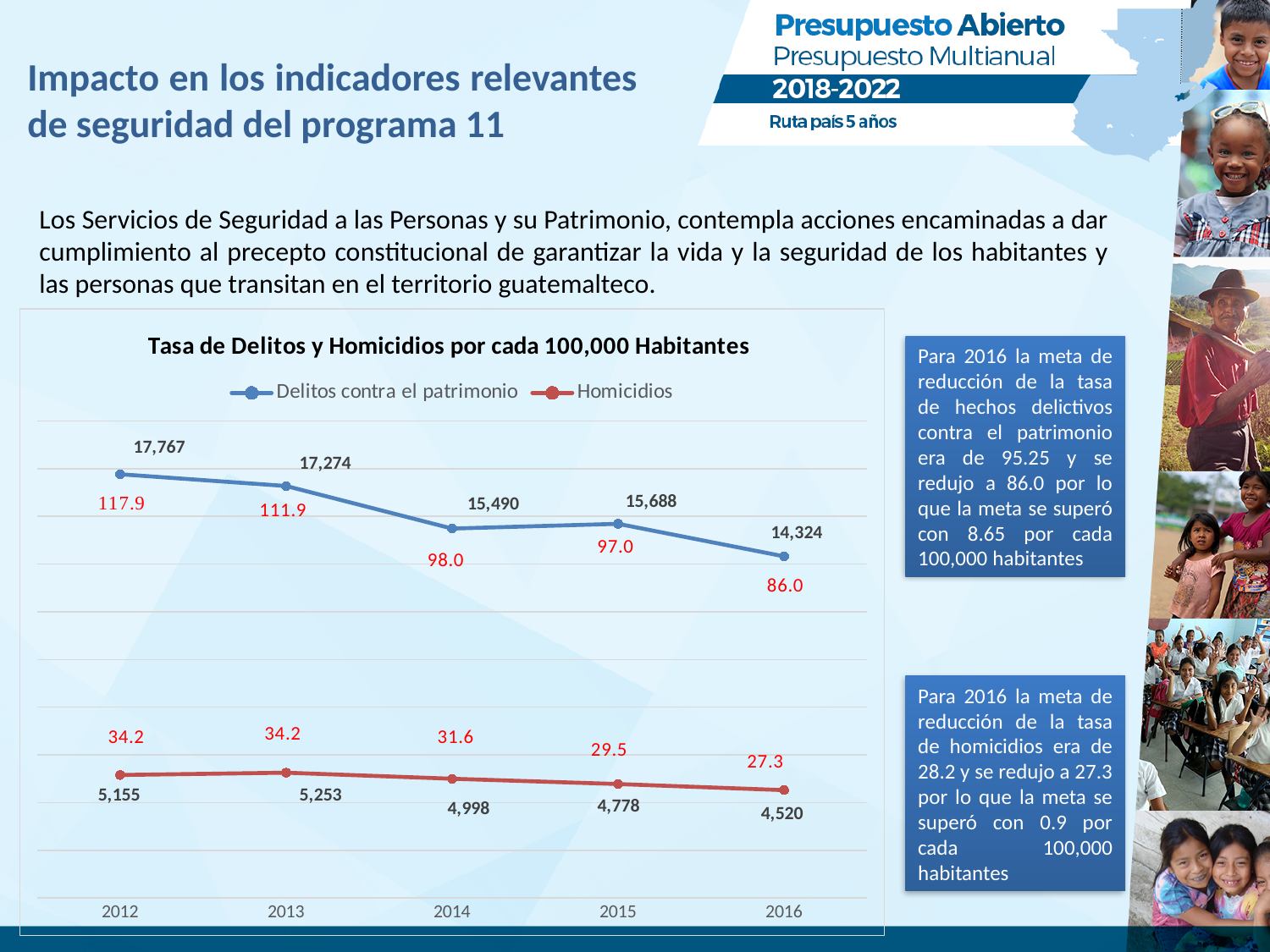
What is the title of the chart? Tasa de Delitos y Homicidios por cada 100,000 Habitantes What is the count (black label) for Homicidios in 2016? 4,520 In which year is the Delitos contra el patrimonio line at its lowest? 2016 What is the difference between the Delitos contra el patrimonio counts in 2012 and 2016 (17,767 and 14,324)? 3,443 What type of chart is shown on the slide? line chart What is the rate (red label) for Homicidios in 2014? 31.6 In which year is the Homicidios count (black label) highest? 2013 How many years are shown on the x axis of the chart? 5 What is the rate (red label) for Delitos contra el patrimonio in 2016? 86.0 How many series does the chart legend list? 2 Does the Homicidios line generally rise or fall from 2013 to 2016? fall What is the count (black label) for Delitos contra el patrimonio in 2012? 17,767